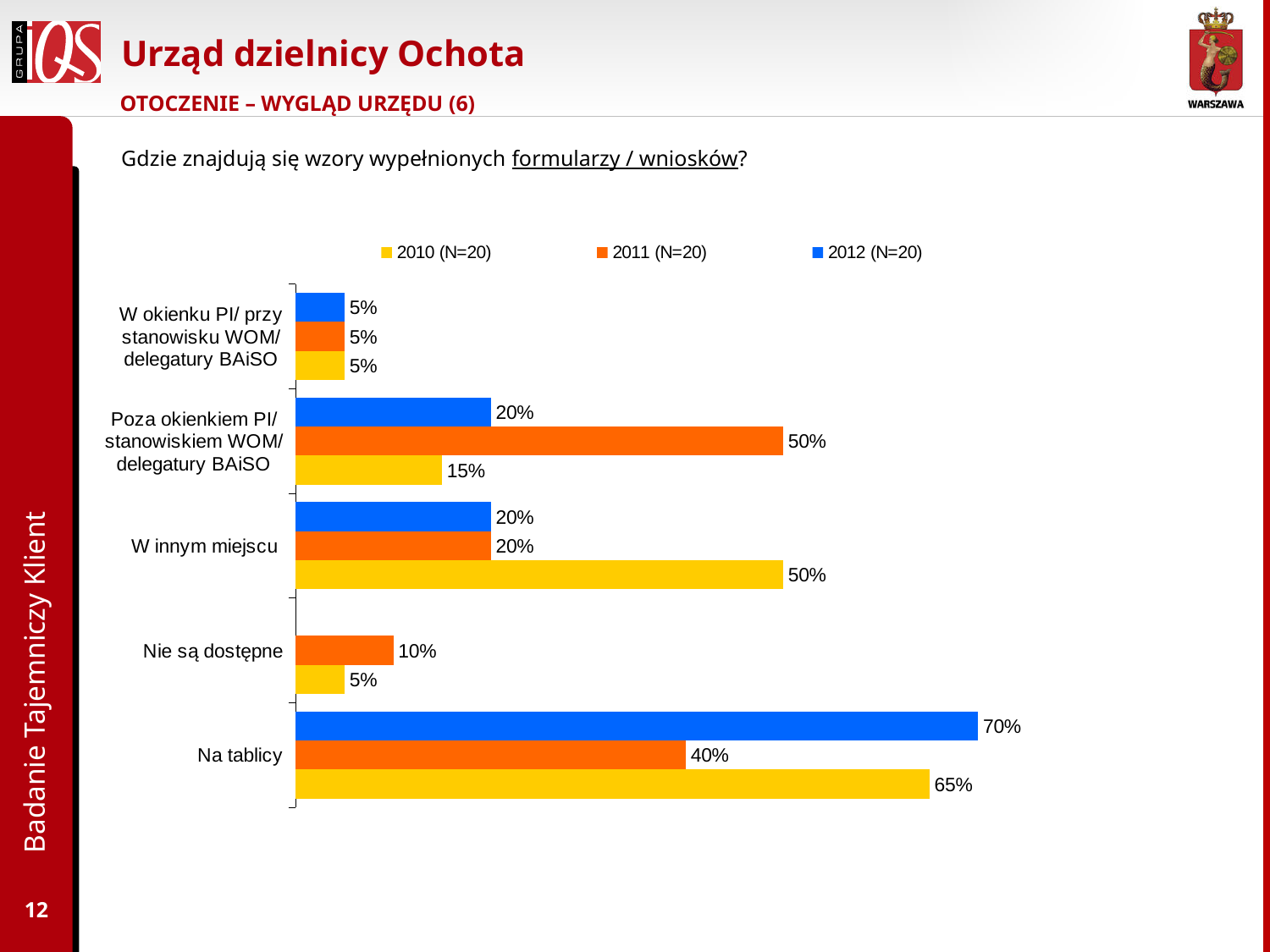
How many series does the legend list? 3 What is the value for 'Nie są dostępne' in the 2011 (N=20) series? 10% Which category has the highest value in the 2012 (N=20) series? Na tablicy Which category has the lowest value in the 2011 (N=20) series? W okienku PI/ przy stanowisku WOM/ delegatury BAiSO What is the difference between the 2012 (N=20) and 2011 (N=20) values for 'Na tablicy'? 30% What is the value for 'W innym miejscu' in the 2010 (N=20) series? 50% What is the value for 'Poza okienkiem PI/ stanowiskiem WOM/ delegatury BAiSO' in the 2011 (N=20) series? 50% How many categories are shown on the chart? 5 What is the value for 'Na tablicy' in the 2012 (N=20) series? 70% What kind of chart is shown on the slide? bar chart For 'Poza okienkiem PI/ stanowiskiem WOM/ delegatury BAiSO', which series has the larger value: 2010 (N=20) or 2012 (N=20)? 2012 (N=20) Which colour represents the 2011 (N=20) series in the legend? orange